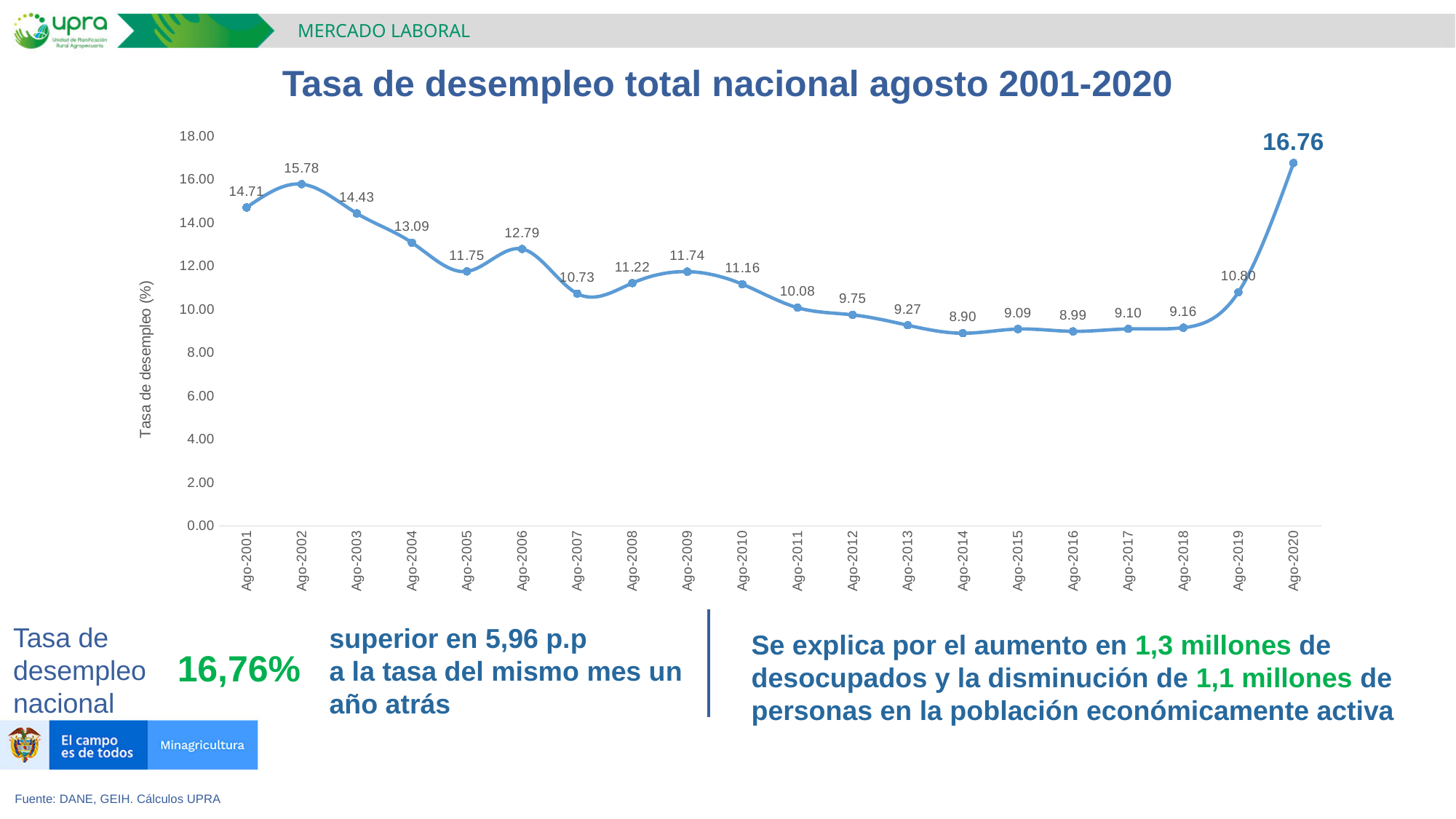
What is the value plotted for Ago-2014? 8.90 Do the values rise or fall from Ago-2002 to Ago-2005? Fall What is the unemployment rate for Ago-2001? 14.71 How many data points are plotted in the chart? 20 What is the difference between the values for Ago-2020 and Ago-2019? 5.96 Which year has the lowest unemployment rate in the chart? Ago-2014 What is the title of the chart? Tasa de desempleo total nacional agosto 2001-2020 What is the value plotted for Ago-2009? 11.74 Which year has the highest unemployment rate in the chart? Ago-2020 Which is larger, the value for Ago-2002 or the value for Ago-2003? Ago-2002 What type of chart is shown on the slide? Line chart What is the unemployment rate for Ago-2020? 16.76